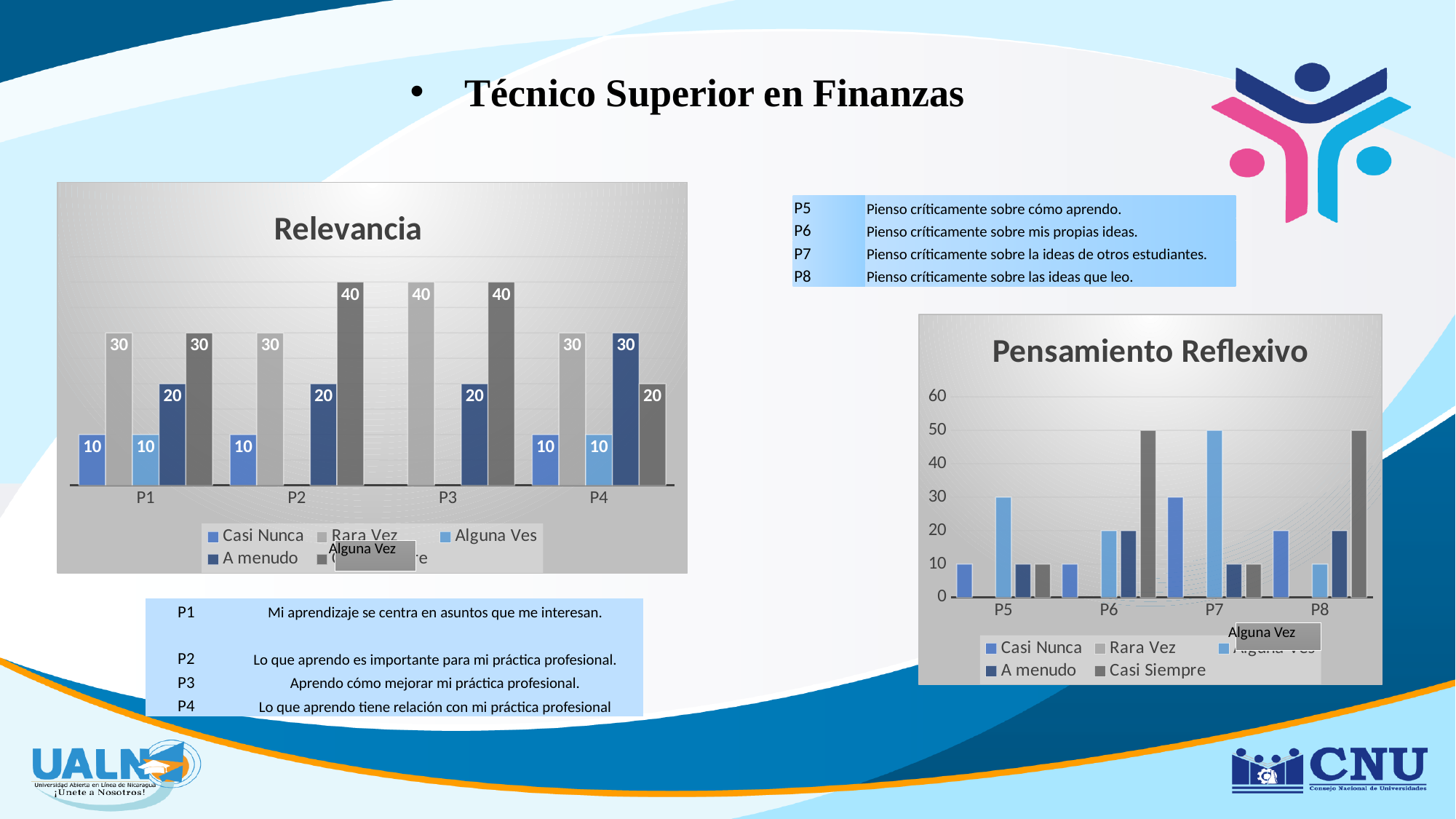
In the "Relevancia" chart, what is the difference between the Casi Siempre value and the A menudo value at P2? 20 In the "Pensamiento Reflexivo" chart, which category has the highest Alguna Ves value? P7 In the "Pensamiento Reflexivo" chart, what is the value for Casi Nunca at P7? 30 In the "Relevancia" chart, is the A menudo value larger at P1 or at P4? P4 How many series does the legend of the "Relevancia" chart list? 5 What kind of chart is the "Relevancia" chart? bar chart What is the highest value shown on the y axis of the "Pensamiento Reflexivo" chart? 60 How many categories are shown on the x axis of the "Relevancia" chart? 4 In the "Relevancia" chart, what is the value for Casi Siempre at P4? 20 In the "Pensamiento Reflexivo" chart, is the Casi Siempre value for P6 greater or less than 40? greater How many categories are shown on the x axis of the "Pensamiento Reflexivo" chart? 4 In the "Relevancia" chart, what is the value for Rara Vez at P3? 40